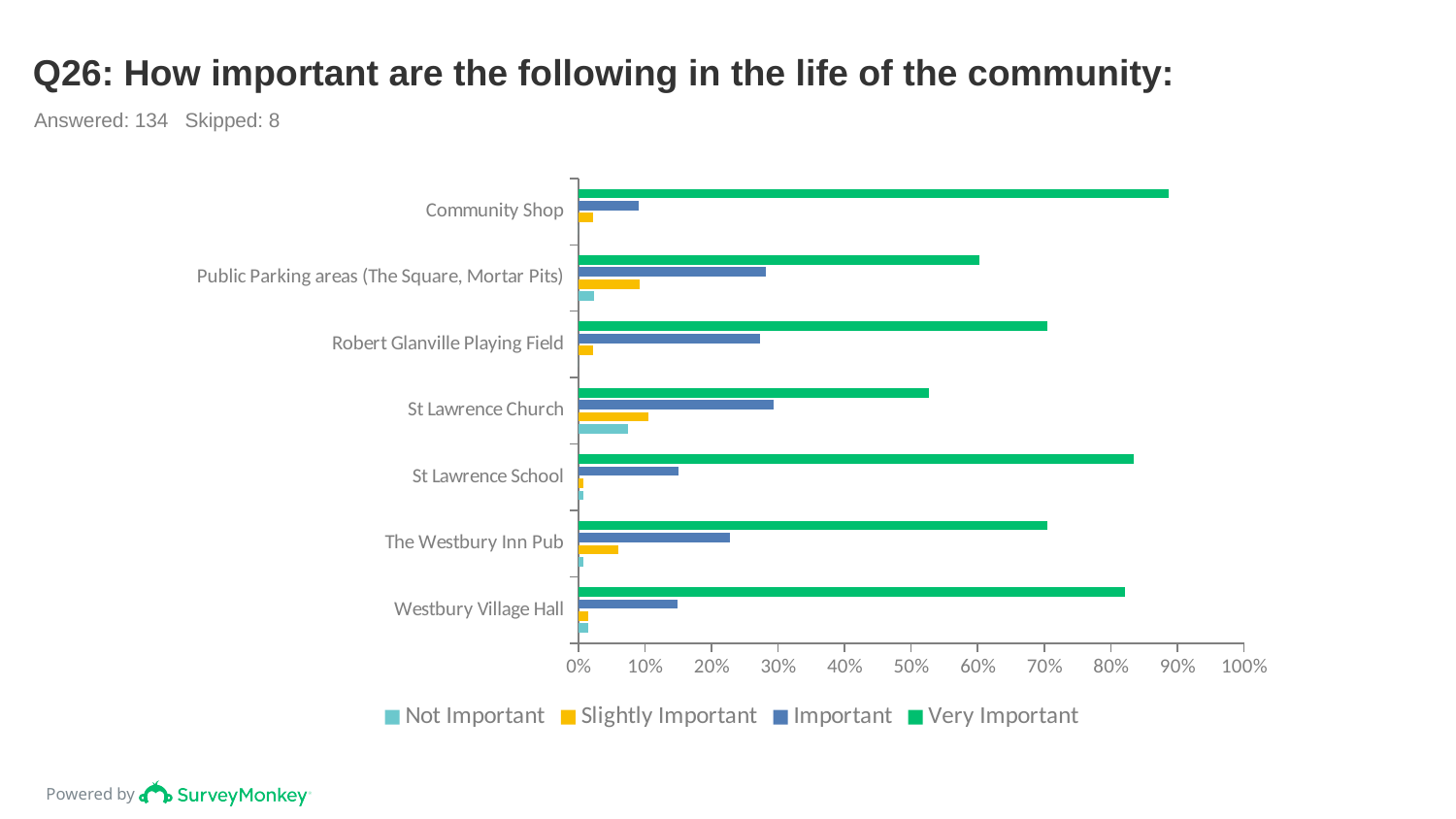
Which has the larger 'Important' value: The Westbury Inn Pub or Westbury Village Hall? The Westbury Inn Pub Which category has the highest 'Not Important' value? St Lawrence Church What kind of chart is shown on the slide? bar chart What colour represents the 'Very Important' series in the legend? green Which has the larger 'Very Important' value: St Lawrence School or Public Parking areas (The Square, Mortar Pits)? St Lawrence School Which category has the lowest 'Very Important' value? St Lawrence Church How many categories (community features) are listed on the chart? 7 How many series does the legend list? 4 Is the 'Important' value for Robert Glanville Playing Field greater or less than 20%? greater Is the 'Very Important' value for Community Shop greater or less than 80%? greater Is the 'Very Important' value for St Lawrence Church greater or less than 60%? less Which category has the highest 'Very Important' value? Community Shop